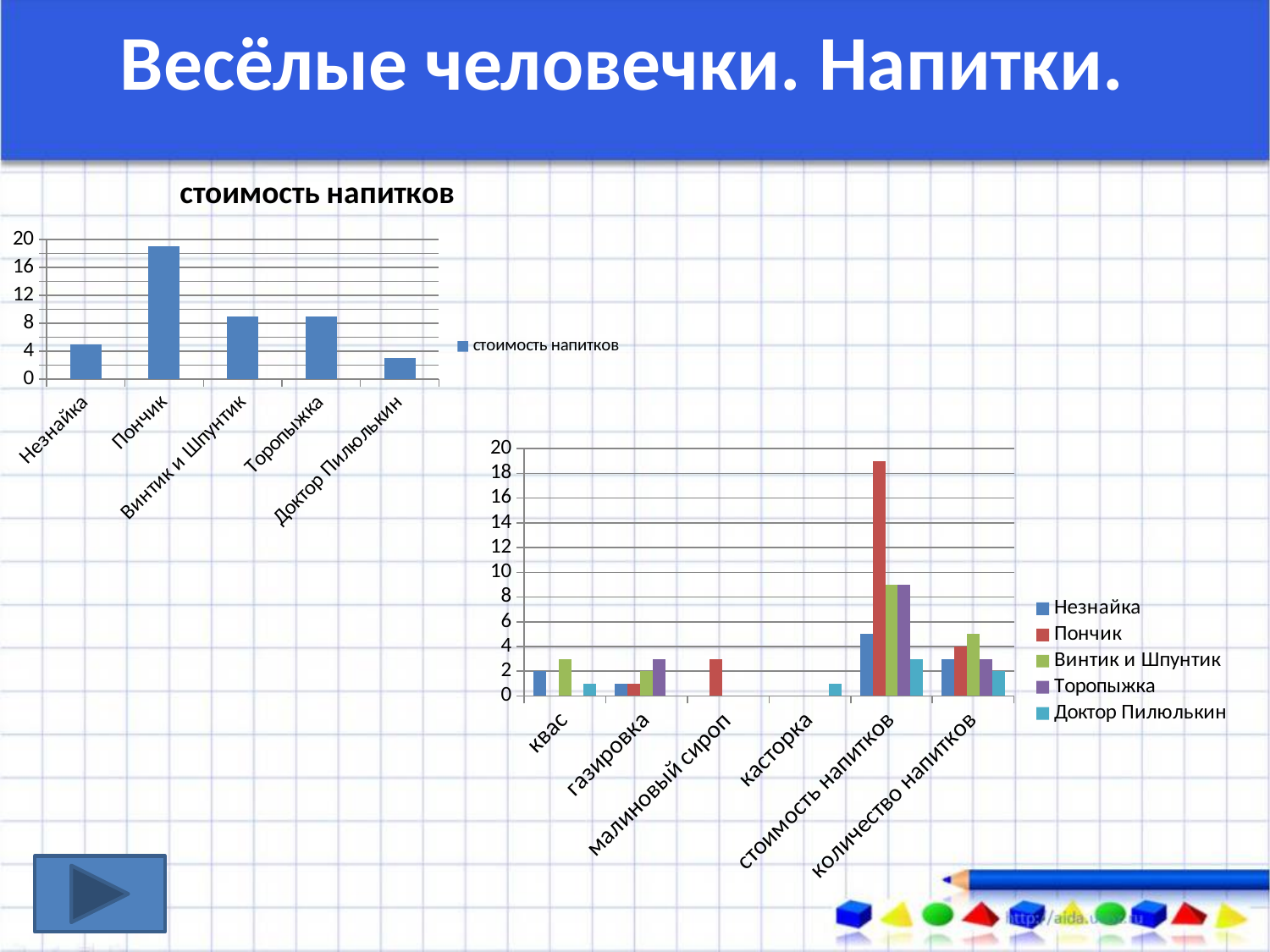
In the top-left chart 'стоимость напитков', is the value for Незнайка greater or less than 8? less In the bottom-right chart, which series has the highest value for стоимость напитков? Пончик In the top-left chart 'стоимость напитков', is the value for Пончик greater or less than 16? greater What kind of chart is the top-left chart titled 'стоимость напитков'? bar chart In the top-left chart 'стоимость напитков', which category has the lowest value? Доктор Пилюлькин In the top-left chart 'стоимость напитков', which category has the highest value? Пончик In the bottom-right chart, how many series does the legend list? 5 In the bottom-right chart, how many categories are shown on the x axis? 6 In the bottom-right chart, what is the value of Пончик for количество напитков? 4 In the top-left chart 'стоимость напитков', which is larger: the value for Пончик or the value for Незнайка? Пончик In the top-left chart 'стоимость напитков', how many categories are shown on the x axis? 5 In the bottom-right chart, what is the value of Незнайка for квас? 2